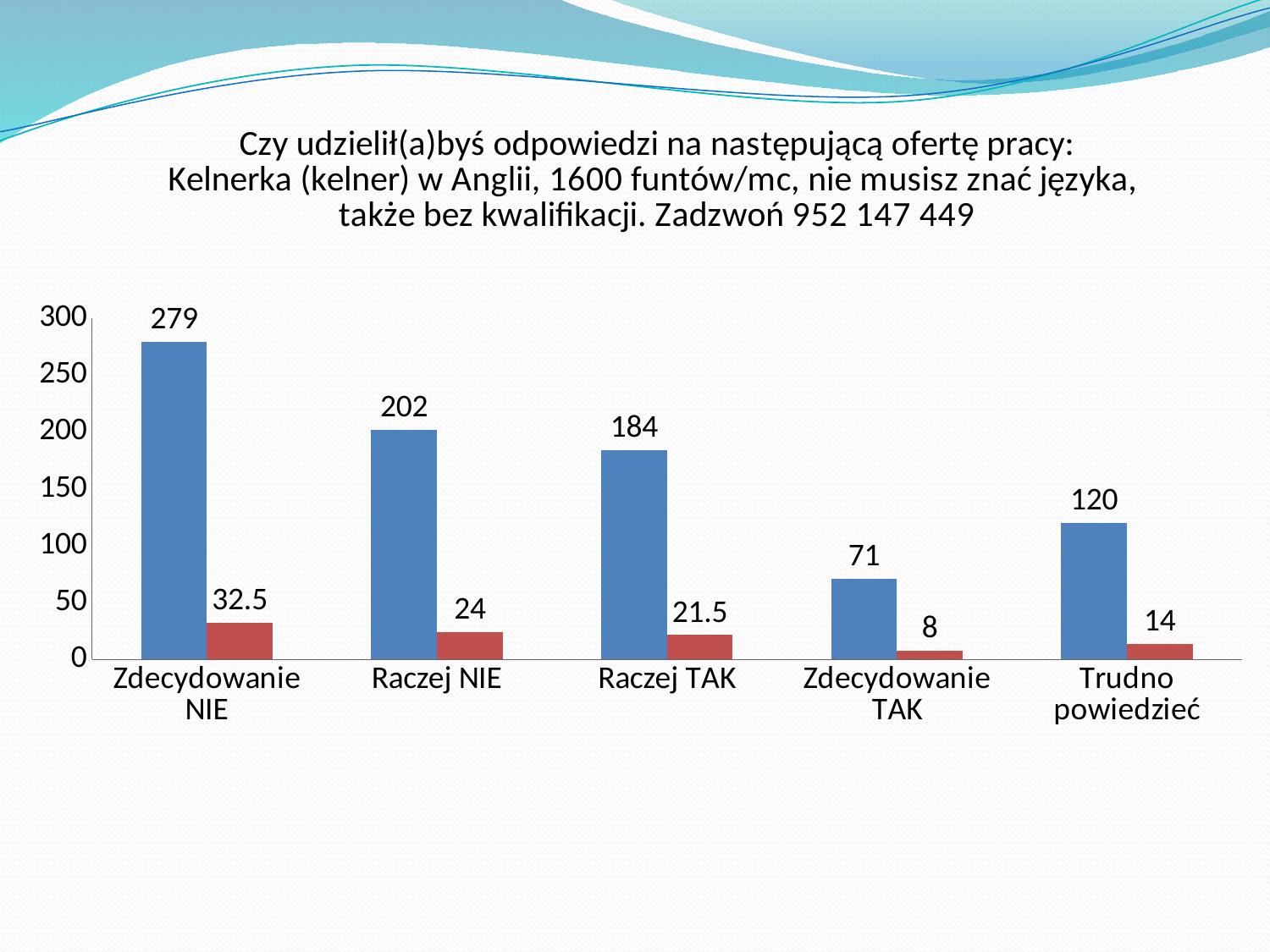
Which is larger: the blue bar for "Zdecydowanie TAK" or the blue bar for "Trudno powiedzieć"? Trudno powiedzieć What is the difference between the blue bars for "Raczej NIE" and "Raczej TAK"? 18 Which category has the highest blue bar? Zdecydowanie NIE What is the difference between the red bars for "Zdecydowanie NIE" and "Raczej NIE"? 8.5 What is the value of the blue bar for "Trudno powiedzieć"? 120 What kind of chart is shown on the slide? bar chart Which category has the lowest red bar? Zdecydowanie TAK What is the value of the blue bar for "Zdecydowanie NIE"? 279 What is the value of the red bar for "Zdecydowanie TAK"? 8 How many categories are shown on the x axis? 5 How many data series (bar colours) are plotted for each category? 2 What is the value of the red bar for "Raczej TAK"? 21.5